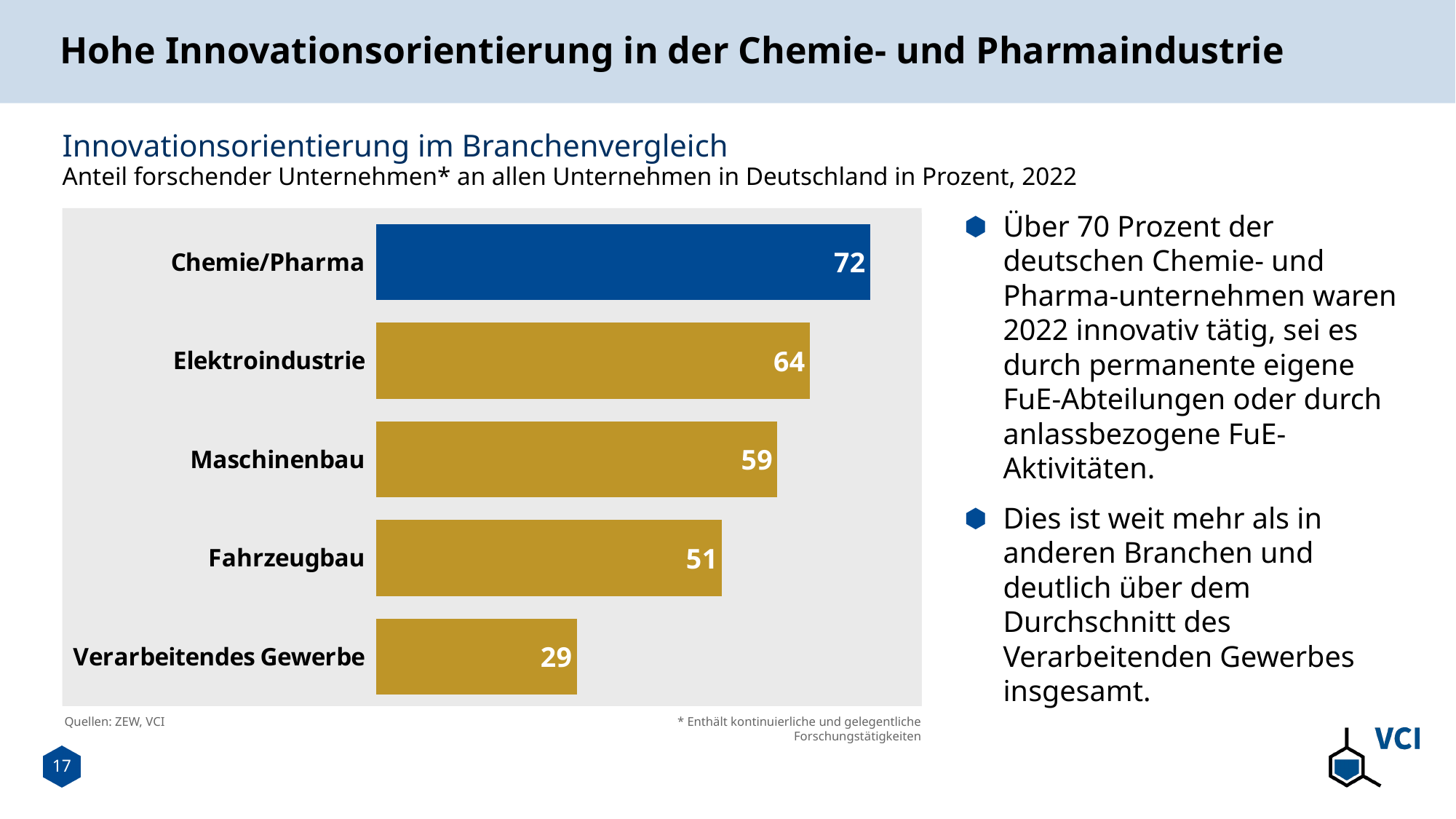
Which category has the lowest value? Verarbeitendes Gewerbe What is the difference between the values for Chemie/Pharma and Verarbeitendes Gewerbe? 43 What kind of chart is shown on the slide? Bar chart What is the value for Fahrzeugbau? 51 Which is larger, the value for Maschinenbau or the value for Fahrzeugbau? Maschinenbau How many categories are shown in the chart? 5 Which bar is shown in a different colour (blue) from the others? Chemie/Pharma What is the value for Chemie/Pharma? 72 Which category has the highest value? Chemie/Pharma What is the value for Maschinenbau? 59 What is the value for Elektroindustrie? 64 What is the value for Verarbeitendes Gewerbe? 29